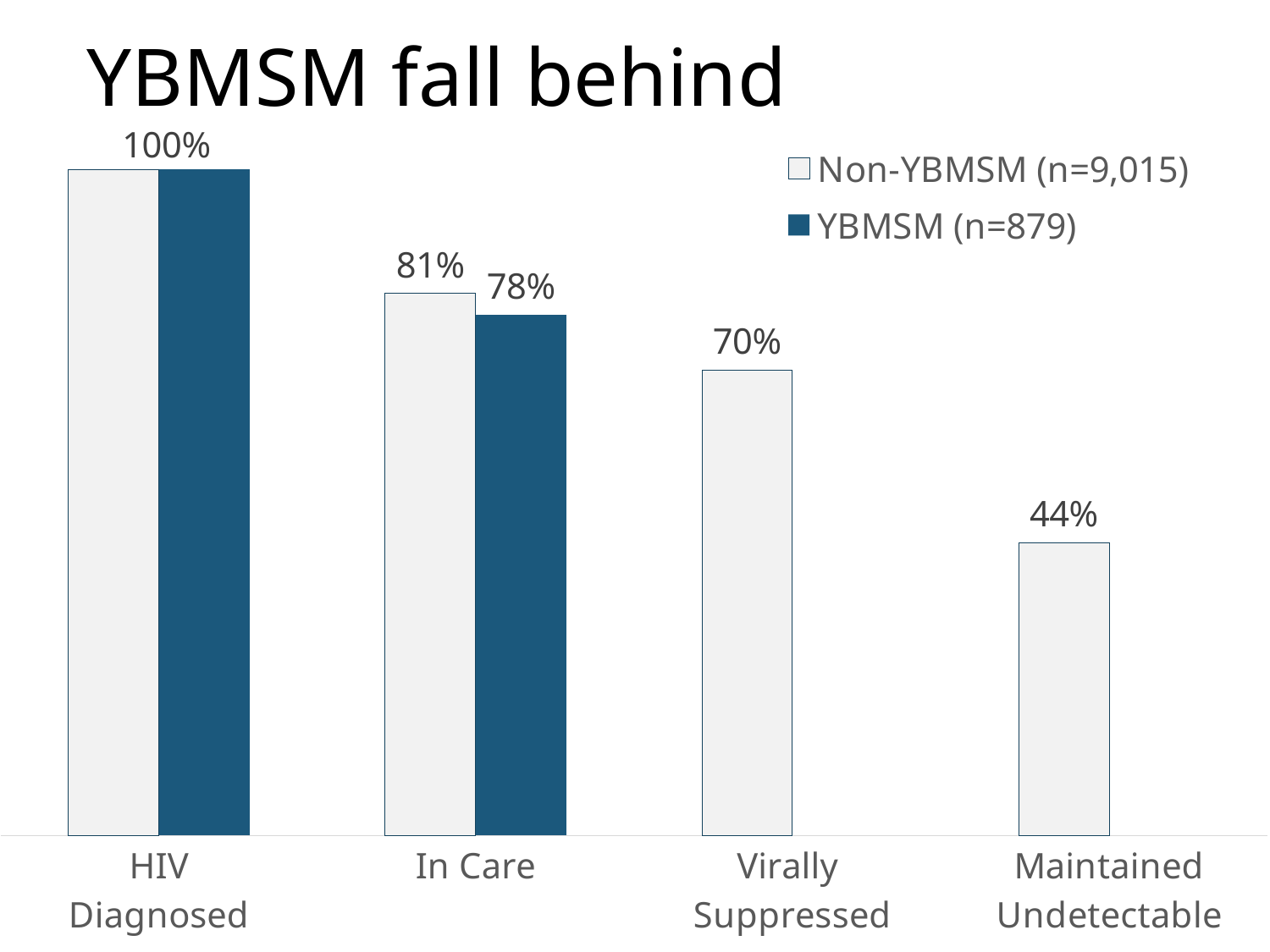
Which category has the lowest Non-YBMSM value? Maintained Undetectable What is the Non-YBMSM value for Maintained Undetectable? 44% What is the difference between the Non-YBMSM and YBMSM values for In Care? 3 percentage points What is the YBMSM value for In Care? 78% What value is labelled for the HIV Diagnosed category? 100% Do the Non-YBMSM values rise or fall from left to right across the categories? Fall What kind of chart is shown on the slide? Bar chart For In Care, which series has the larger value, Non-YBMSM or YBMSM? Non-YBMSM What is the Non-YBMSM value for Virally Suppressed? 70% How many series does the legend list? 2 How many categories are shown on the x axis? 4 What is the Non-YBMSM value for In Care? 81%